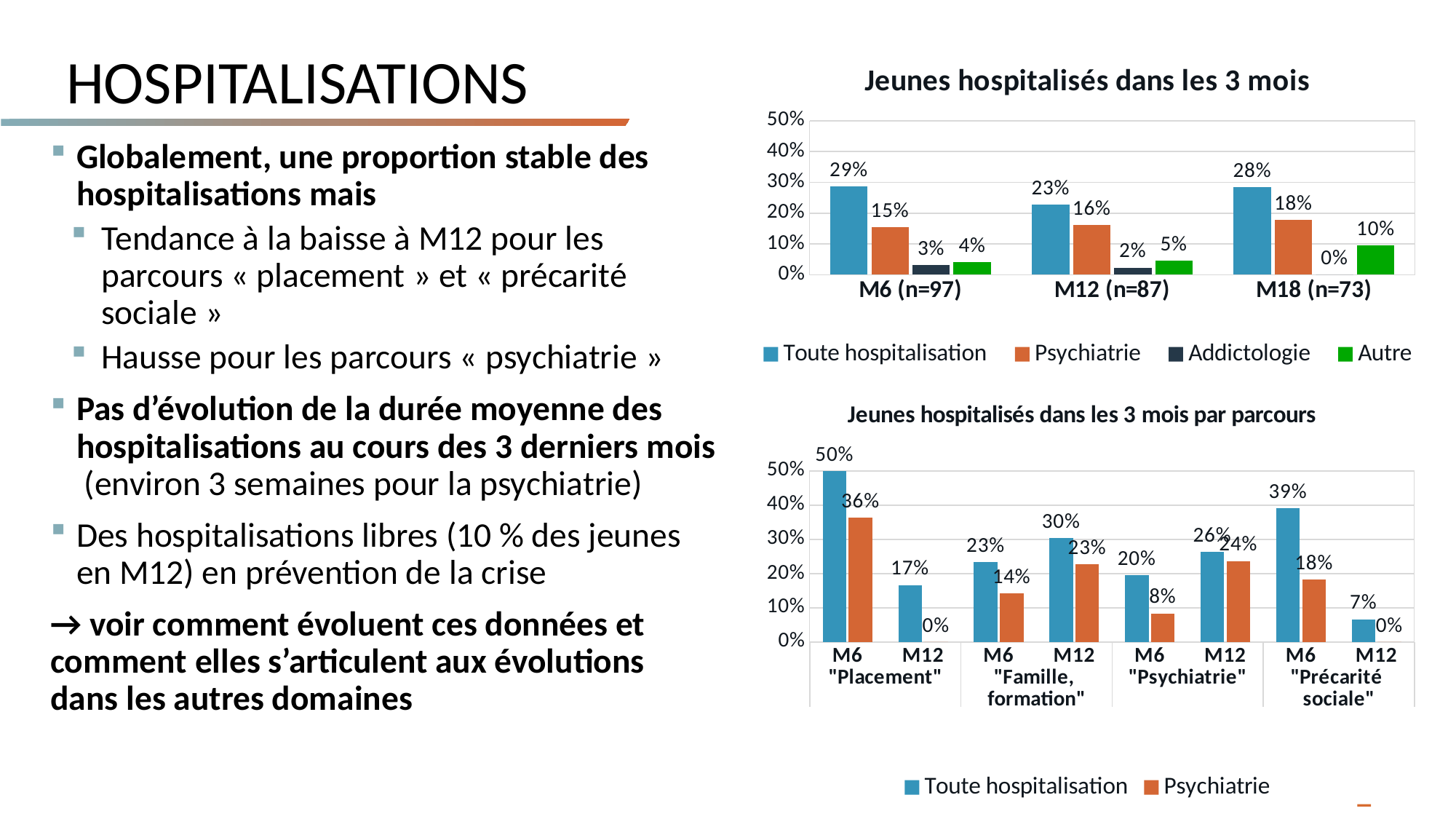
In the chart 'Jeunes hospitalisés dans les 3 mois', does 'Addictologie' rise or fall from M6 to M18? fall What type of chart is 'Jeunes hospitalisés dans les 3 mois par parcours'? bar chart In the chart 'Jeunes hospitalisés dans les 3 mois par parcours', what is the value of 'Toute hospitalisation' for M6 'Placement'? 50% In the chart 'Jeunes hospitalisés dans les 3 mois par parcours', what is the difference between 'Toute hospitalisation' for M6 'Précarité sociale' and M12 'Précarité sociale'? 32% In the chart 'Jeunes hospitalisés dans les 3 mois', at which time point is 'Psychiatrie' highest? M18 (n=73) In the chart 'Jeunes hospitalisés dans les 3 mois', what is the value of 'Autre' at M18 (n=73)? 10% In the chart 'Jeunes hospitalisés dans les 3 mois', what is the difference between 'Toute hospitalisation' at M6 (n=97) and at M12 (n=87)? 6% How many series does the legend of the chart 'Jeunes hospitalisés dans les 3 mois' list? 4 In the chart 'Jeunes hospitalisés dans les 3 mois', what is the value of 'Toute hospitalisation' at M6 (n=97)? 29% In the chart 'Jeunes hospitalisés dans les 3 mois par parcours', which category has the lowest 'Toute hospitalisation' value? M12 'Précarité sociale' In the chart 'Jeunes hospitalisés dans les 3 mois par parcours', which is larger for 'Toute hospitalisation': M6 'Psychiatrie' or M12 'Psychiatrie'? M12 'Psychiatrie' In the chart 'Jeunes hospitalisés dans les 3 mois par parcours', what is the value of 'Psychiatrie' for M12 'Famille, formation'? 23%